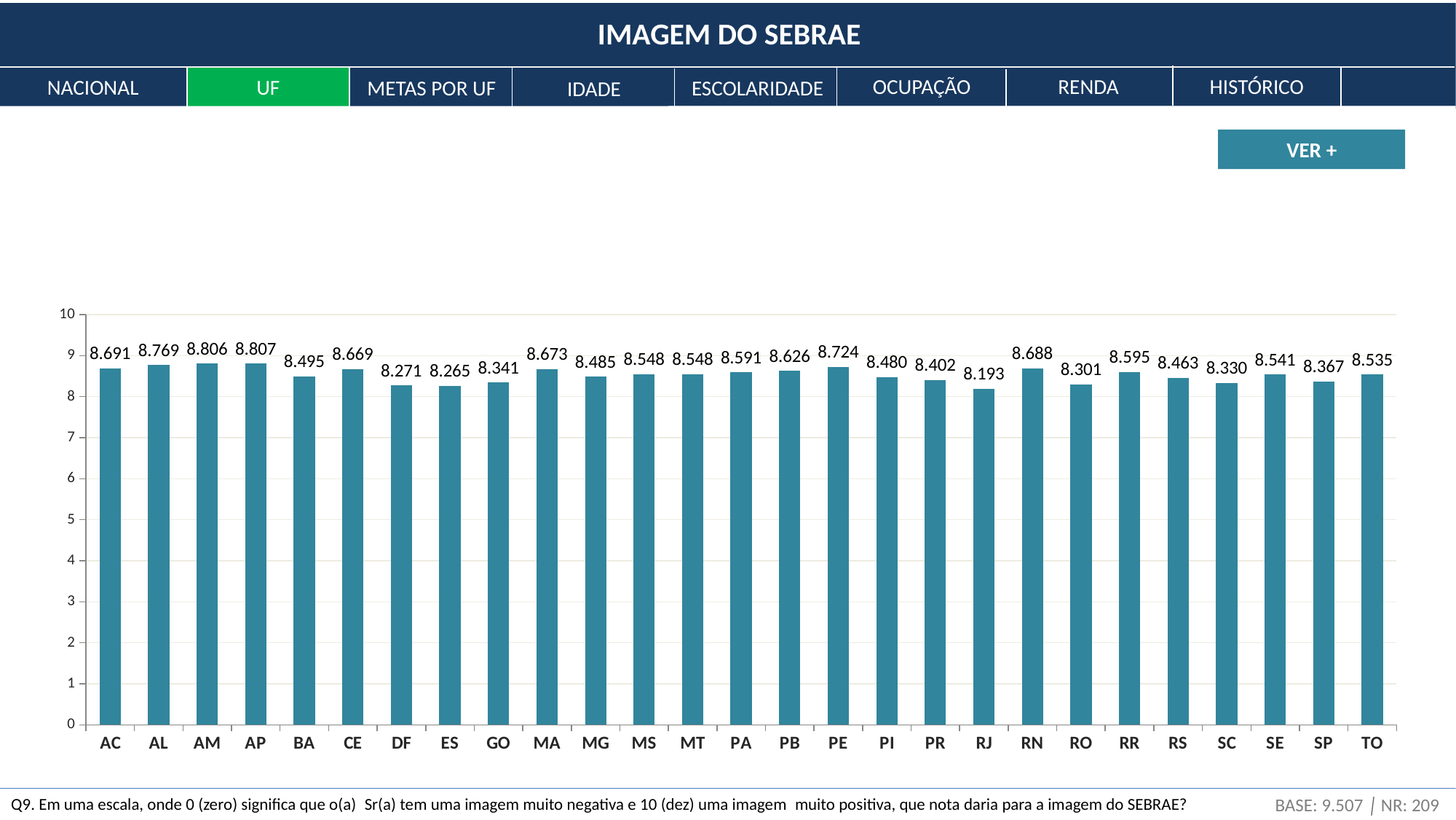
What is the value for DF? 8.271 What is the difference between the values for AP and RJ? 0.614 What is the value for TO? 8.535 How many UFs are shown on the x axis? 27 Is the value for ES greater or less than 8? greater What is the value for PE? 8.724 What is the value for RJ? 8.193 Which is larger, the value for AL or the value for BA? AL What kind of chart is shown? bar chart What is the title at the top of the slide? IMAGEM DO SEBRAE Which UF has the lowest value? RJ Which UF has the highest value? AP